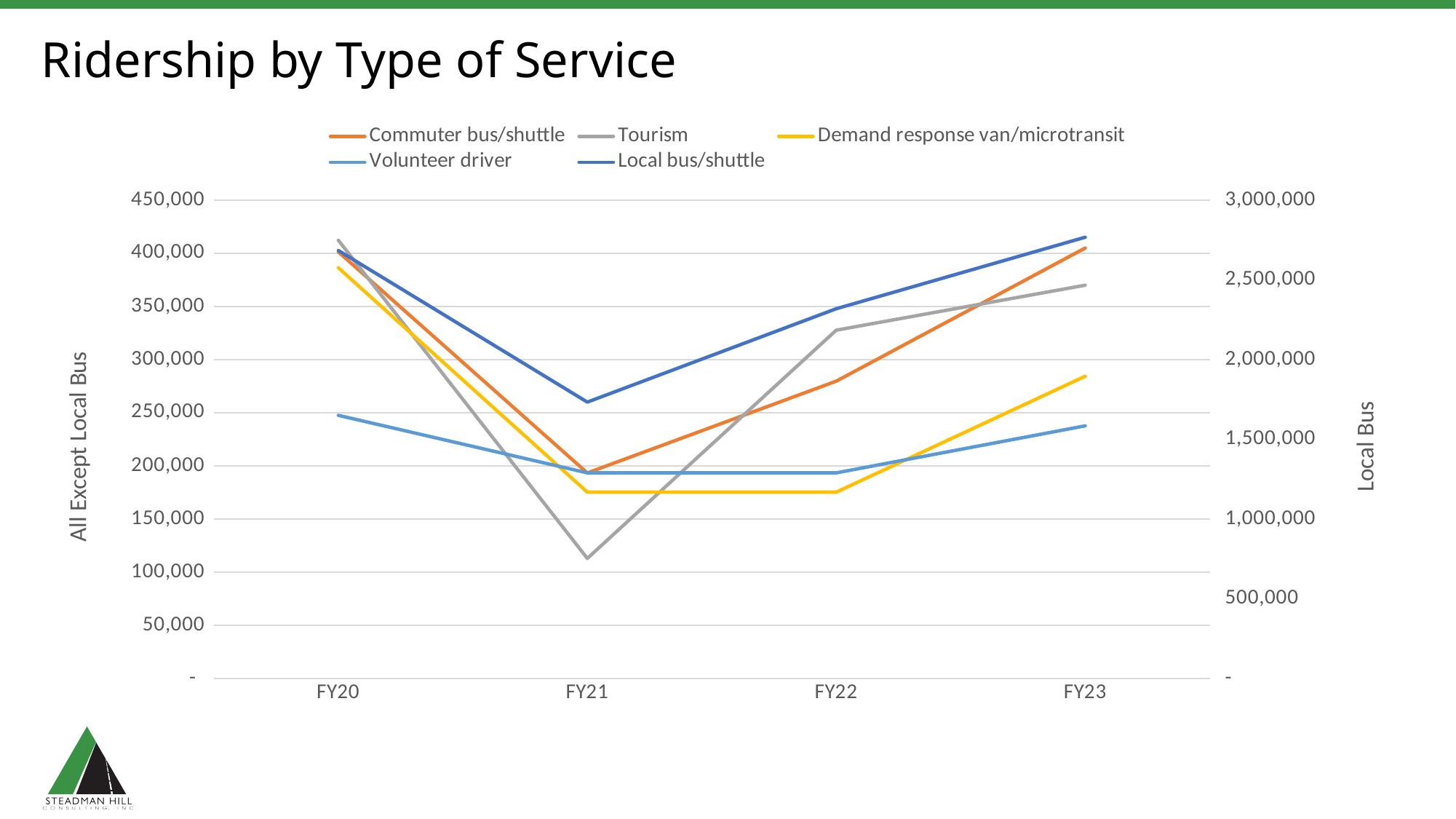
On the right-hand Local Bus axis, is the value for Local bus/shuttle in FY21 greater or less than 2,000,000? less How many series does the legend list? 5 Is the value for Commuter bus/shuttle in FY23 greater or less than 350,000? greater How many fiscal years are plotted along the x axis? 4 What is the title of the left vertical axis? All Except Local Bus In which fiscal year does the Tourism line reach its lowest point? FY21 What is the title of the right vertical axis? Local Bus What kind of chart is shown on the slide? line chart Does the Commuter bus/shuttle line rise or fall from FY21 to FY23? rise Is the value for Volunteer driver in FY20 greater or less than 200,000? greater In FY22, which is higher: Tourism or Commuter bus/shuttle? Tourism